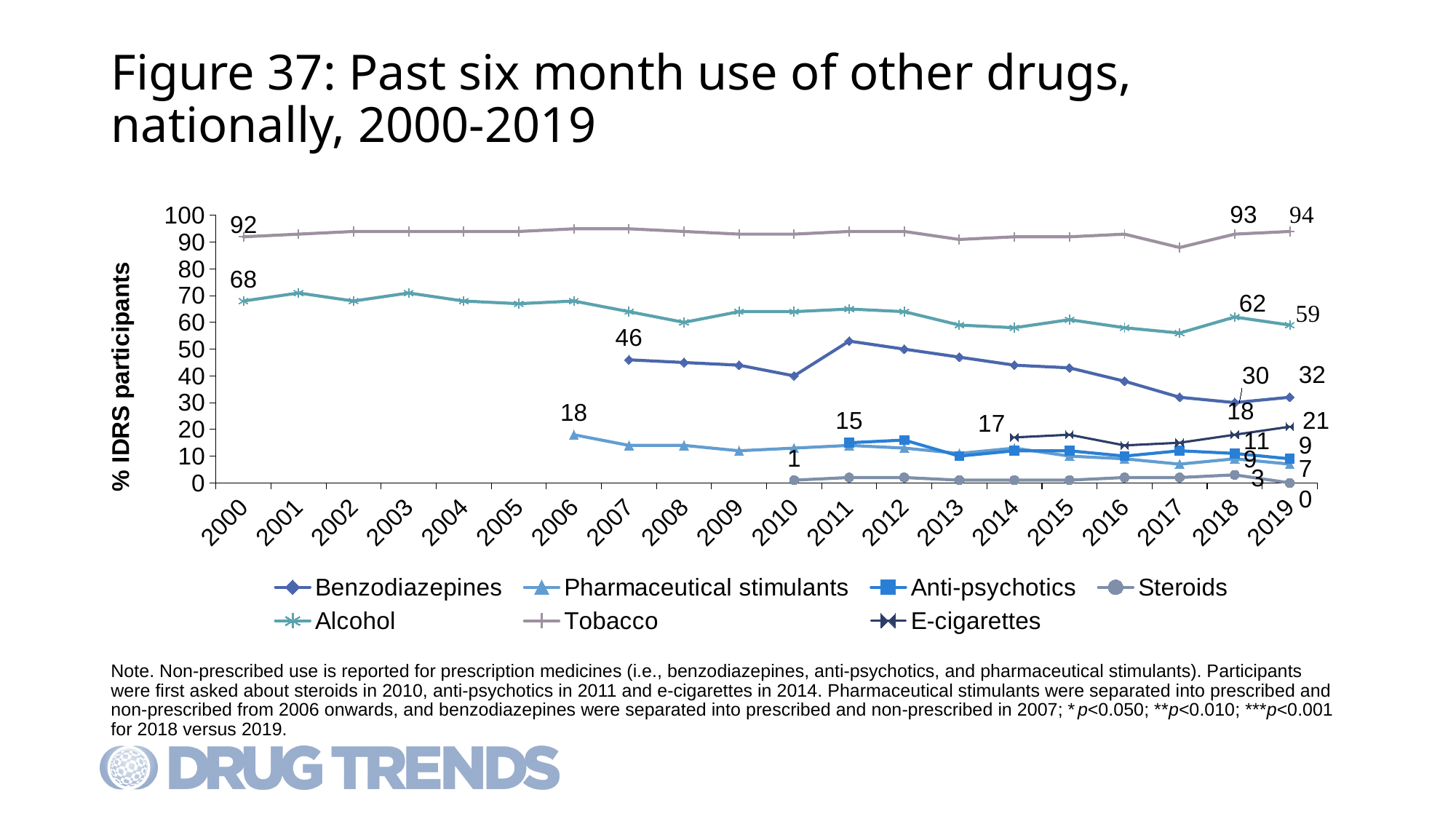
How many series does the legend list? 7 What is the value for Benzodiazepines in 2007? 46 Which series has the highest value in 2019? Tobacco Is the value for Tobacco in 2017 greater or less than 80? greater What is the value for Steroids in 2019? 0 Do the Benzodiazepines values rise or fall from 2011 to 2018? fall What is the value for E-cigarettes in 2019? 21 Is the Alcohol value larger in 2000 or in 2019? 2000 What is the value for Tobacco in 2019? 94 What is the difference between the Tobacco and Alcohol values in 2019? 35 What is the value for Alcohol in 2000? 68 What kind of chart is shown on the slide? line chart